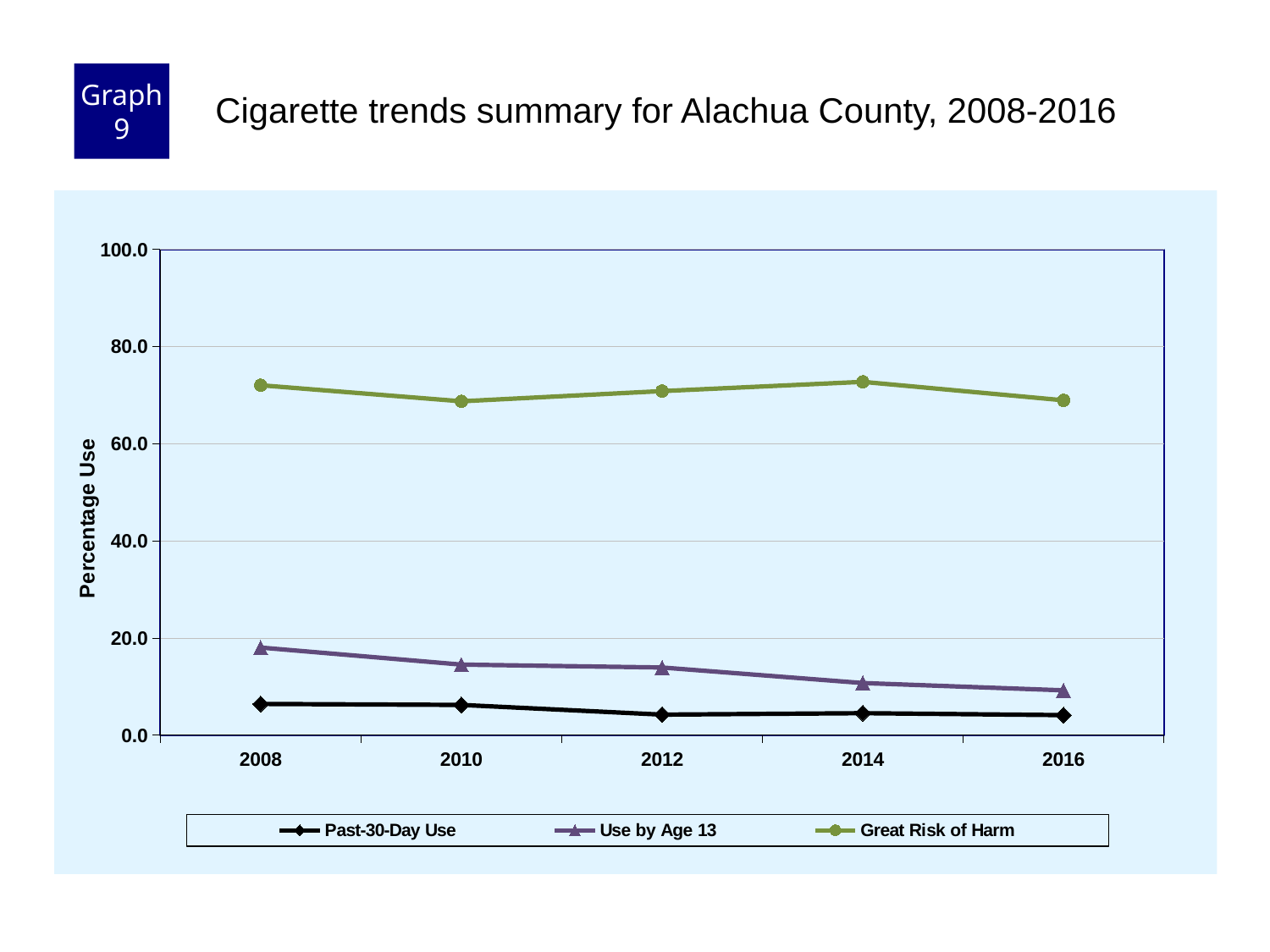
How many years are plotted along the x axis? 5 Is the value for Past-30-Day Use in 2016 greater or less than 20.0? less What is the label on the y axis? Percentage Use What is the title of the chart? Cigarette trends summary for Alachua County, 2008-2016 Which series has the highest values across all years? Great Risk of Harm What kind of chart is shown on the slide? line chart Is the value for Use by Age 13 in 2008 greater or less than 20.0? less Is the value for Great Risk of Harm in 2014 greater or less than 60.0? greater Which series has the lowest values across all years? Past-30-Day Use Which is larger in 2016: Use by Age 13 or Past-30-Day Use? Use by Age 13 How many series does the legend list? 3 Does the Use by Age 13 series rise or fall from 2008 to 2016? fall